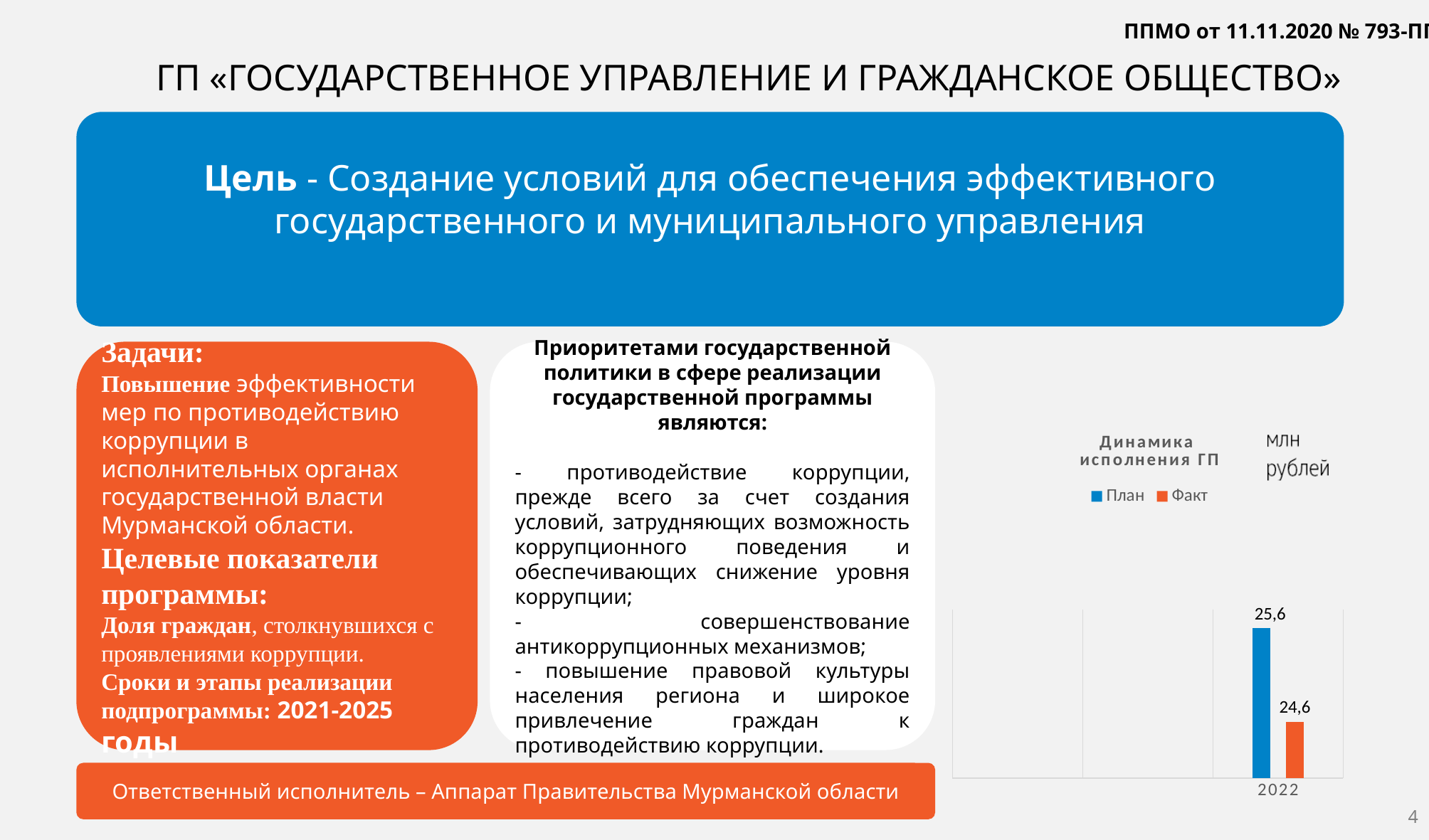
What is the value of План for 2022 in the chart? 25,6 What is the value of Факт for 2022 in the chart? 24,6 What kind of chart is shown on the slide? bar chart What unit is indicated next to the chart title? млн рублей What is the difference between План and Факт for 2022? 1,0 Which year is shown on the x axis of the chart? 2022 What is the title of the chart? Динамика исполнения ГП How many series does the chart legend list? 2 Which series has the higher value for 2022, План or Факт? План How many categories are shown on the x axis of the chart? 1